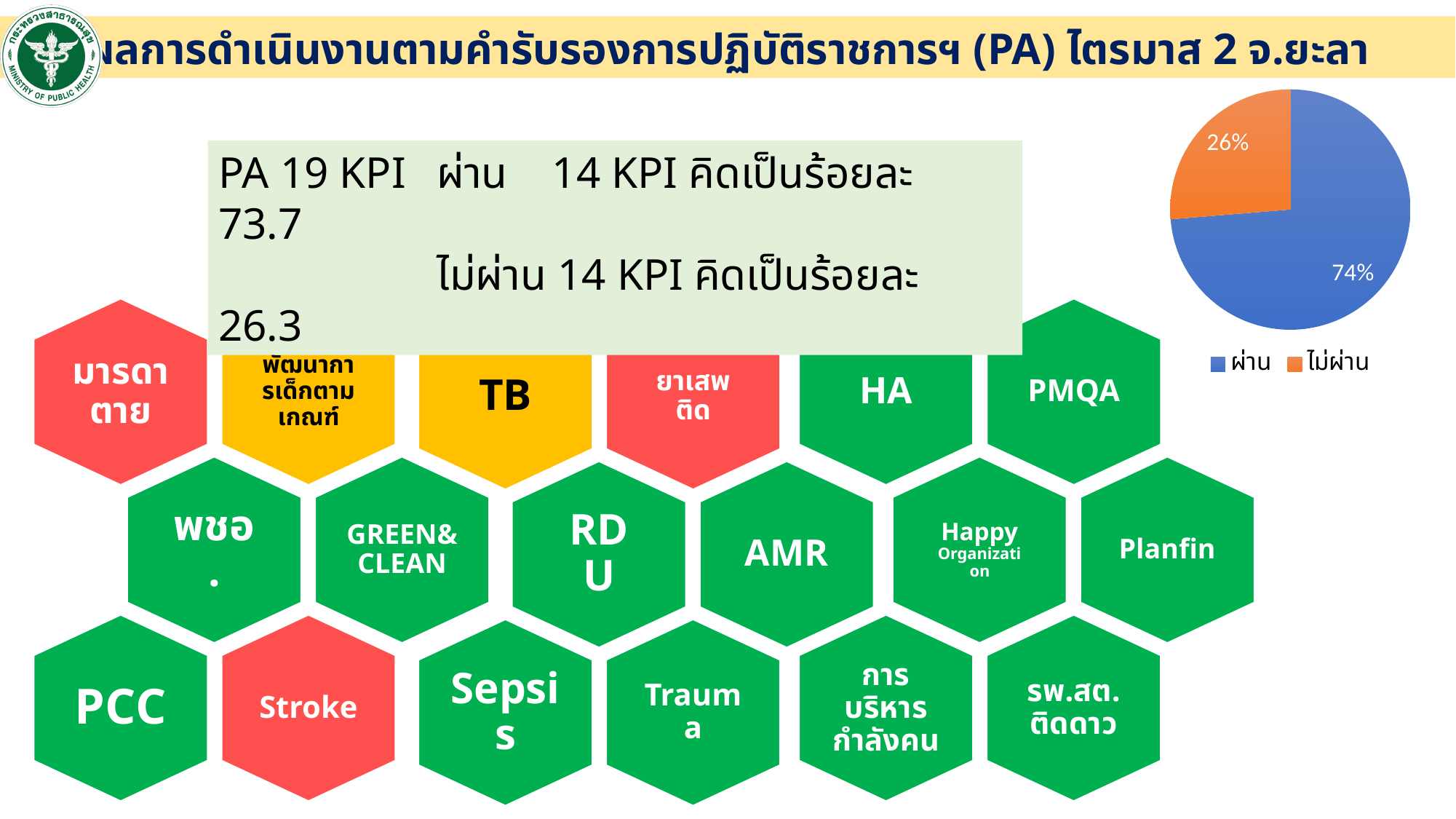
How many entries does the pie chart's legend list? 2 Which slice of the pie chart is the largest? ผ่าน What colour is the ไม่ผ่าน slice in the pie chart? orange What share of the pie chart does ผ่าน represent? 74% What kind of chart is shown on the slide? pie chart How many slices does the pie chart have? 2 What share of the pie chart does ไม่ผ่าน represent? 26% Is the share for ไม่ผ่าน in the pie chart greater or less than 50%? less What is the difference in percentage points between the ผ่าน and ไม่ผ่าน slices of the pie chart? 48 Which is larger in the pie chart, ผ่าน or ไม่ผ่าน? ผ่าน What colour is the ผ่าน slice in the pie chart? blue Which slice of the pie chart is the smallest? ไม่ผ่าน